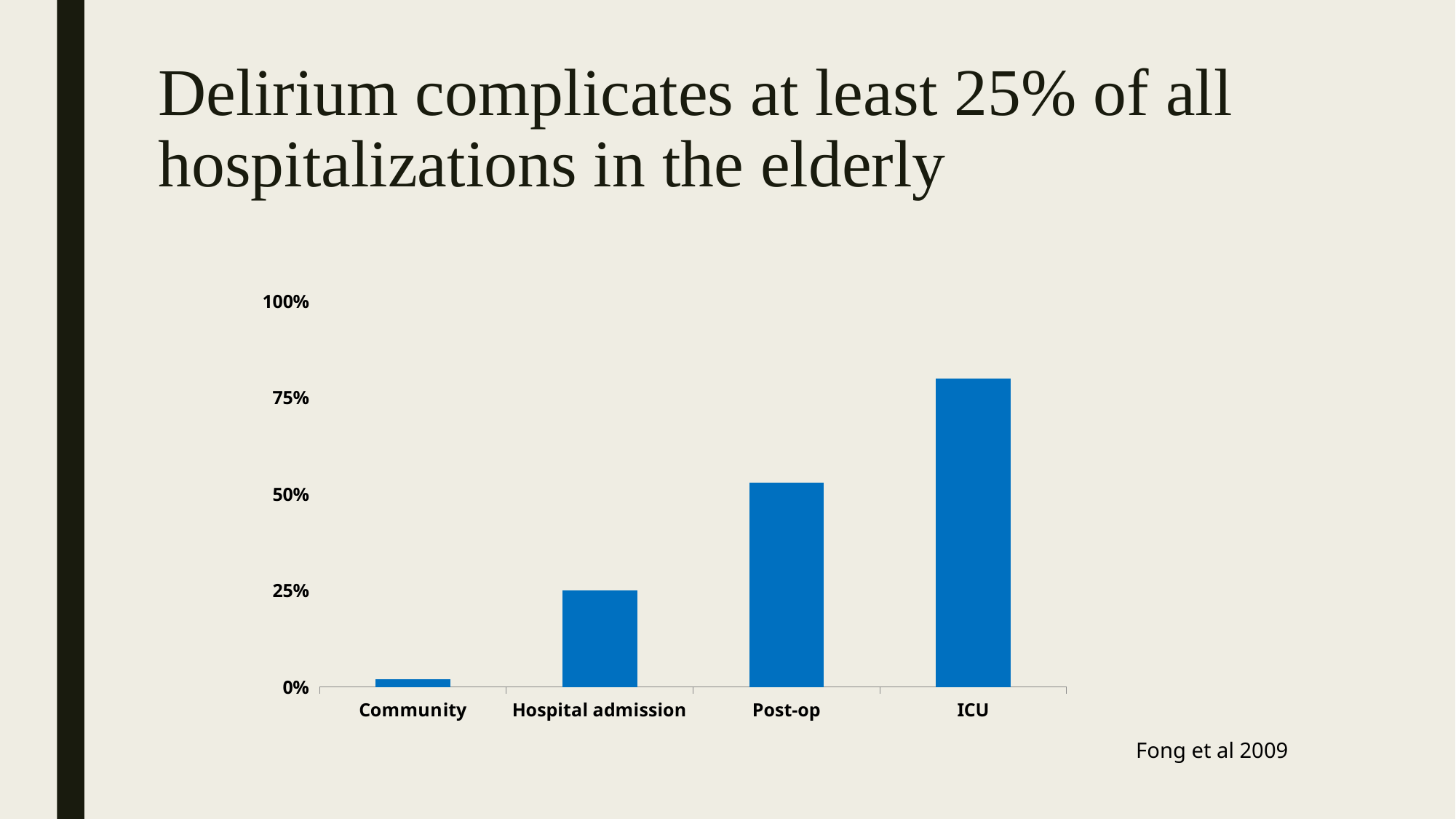
What is the value for Hospital admission? 25% Which is larger, the value for Post-op or the value for Hospital admission? Post-op Do the values rise or fall from Community to ICU along the x axis? rise Is the value for Community greater or less than 25%? less Which category has the highest value in the chart? ICU Is the value for ICU greater or less than 100%? less What source is cited below the chart? Fong et al 2009 Which category has the lowest value in the chart? Community Is the value for Post-op greater or less than 50%? greater How many categories are shown on the x axis of the chart? 4 What kind of chart is shown on the slide? bar chart